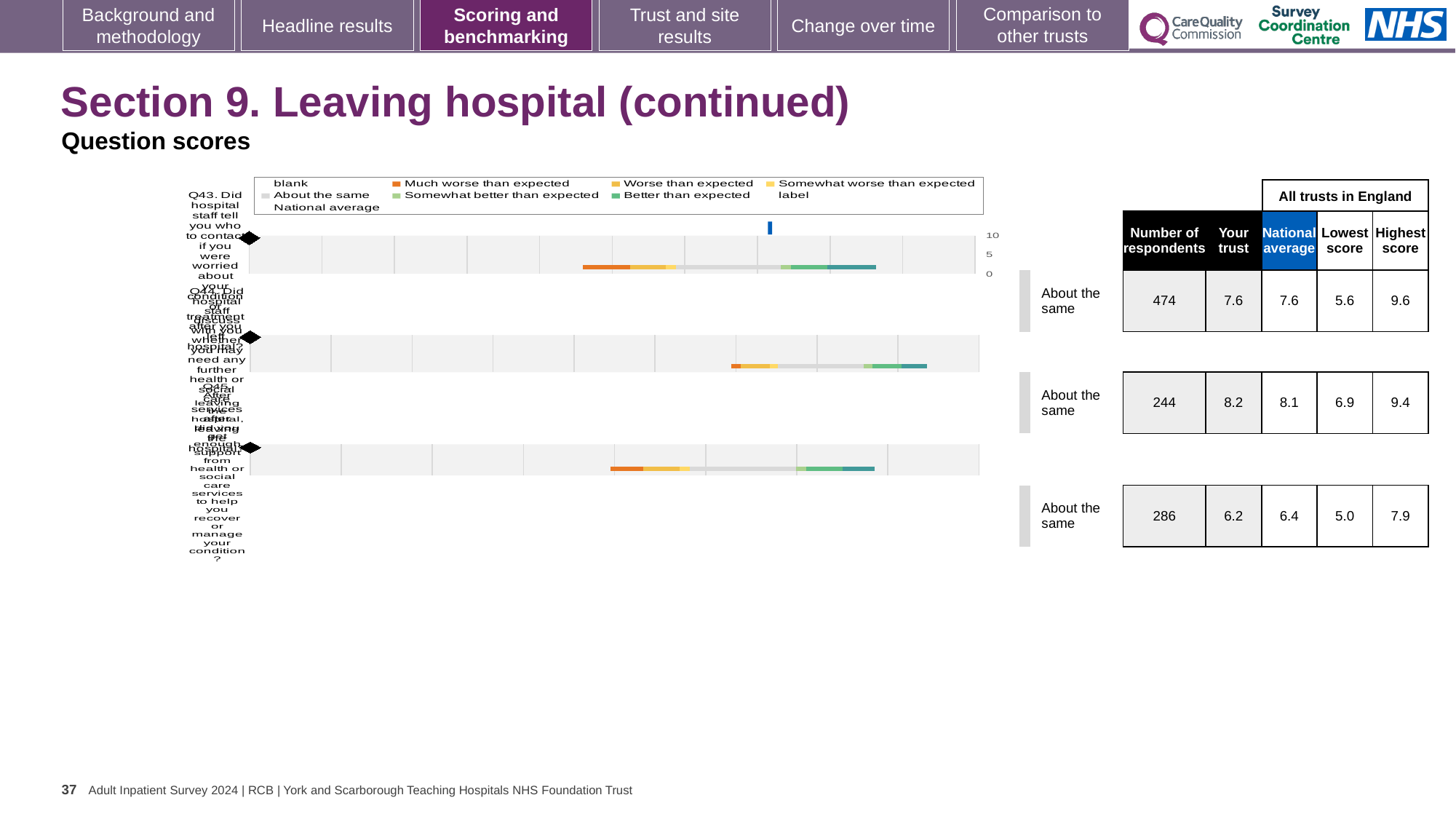
What is the 'Your trust' score for Q43 (Did hospital staff tell you who to contact if you were worried about your condition or treatment after you left hospital)? 7.6 Which question has the lowest 'Your trust' score? Q45 What is the highest score among all trusts in England for Q44? 9.4 What kind of chart is used to show the question scores on this slide? bar chart What is the difference between the 'Your trust' scores for Q44 and Q45? 2.0 What is the 'Your trust' score for Q45 (After leaving hospital, did you get enough support from health or social care services to help you recover or manage your condition)? 6.2 For Q45, which is larger: the 'Your trust' score or the national average? National average How many respondents answered Q43? 474 Which question has the highest 'Your trust' score? Q44 How many questions are plotted in the question scores charts on this slide? 3 What is the lowest score among all trusts in England for Q45? 5.0 What is the 'Your trust' score for Q44 (Did hospital staff discuss with you whether you may need any further health or social care services after leaving hospital)? 8.2